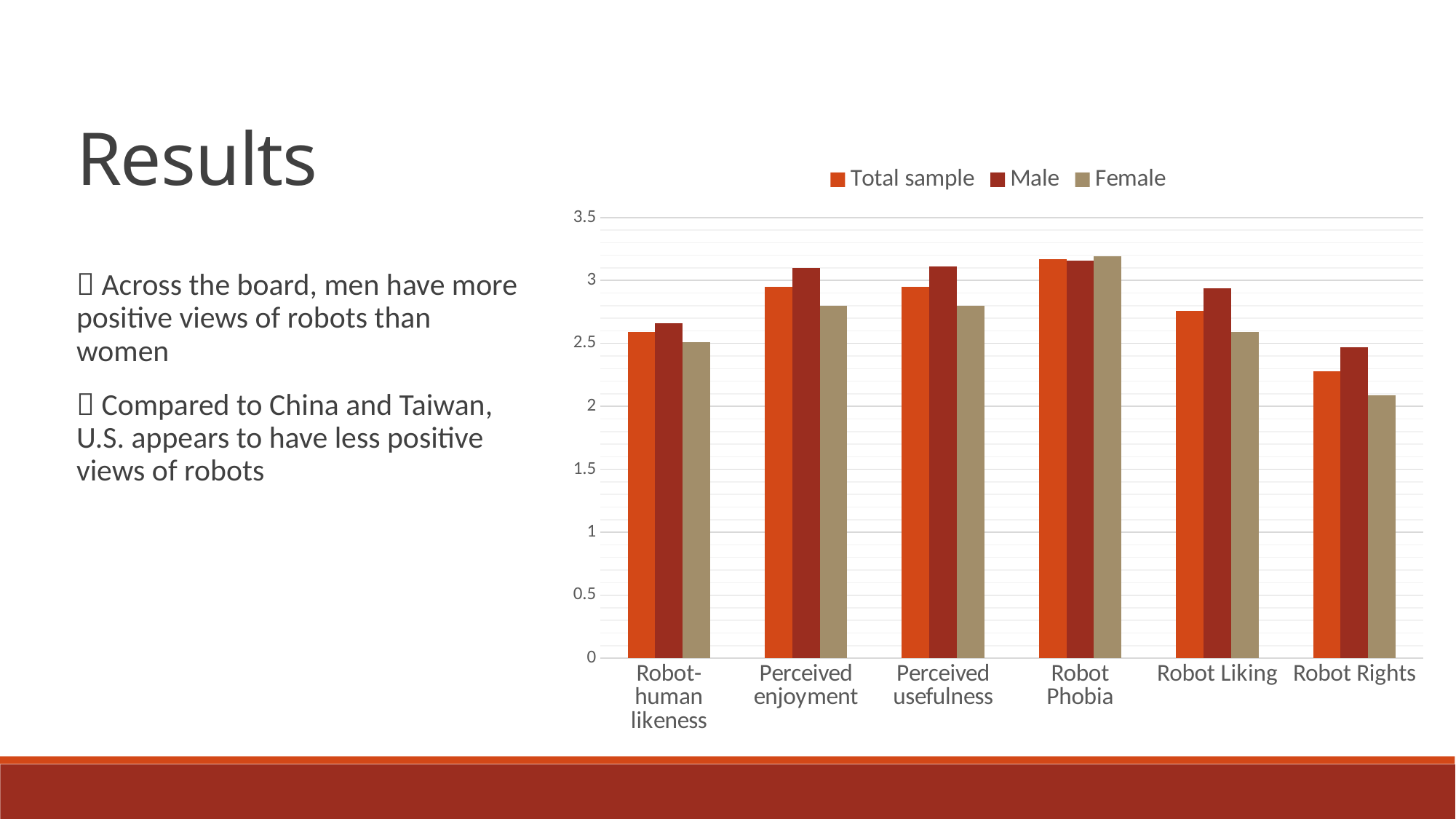
Which category has the highest Female value? Robot Phobia What kind of chart is shown on the slide? bar chart Which category has the lowest Female value? Robot Rights Which series is shown in the lightest (tan) colour in the legend? Female For Robot Rights, which is larger: the Male value or the Female value? Male Is the Total sample value for Robot Rights greater or less than 2.5? less How many categories are shown on the x axis? 6 How many series does the legend list? 3 Is the Female value for Perceived usefulness greater or less than 3? less Is the Male value for Perceived enjoyment greater or less than 3? greater Which category has the highest Total sample value? Robot Phobia Which category has the lowest Male value? Robot Rights